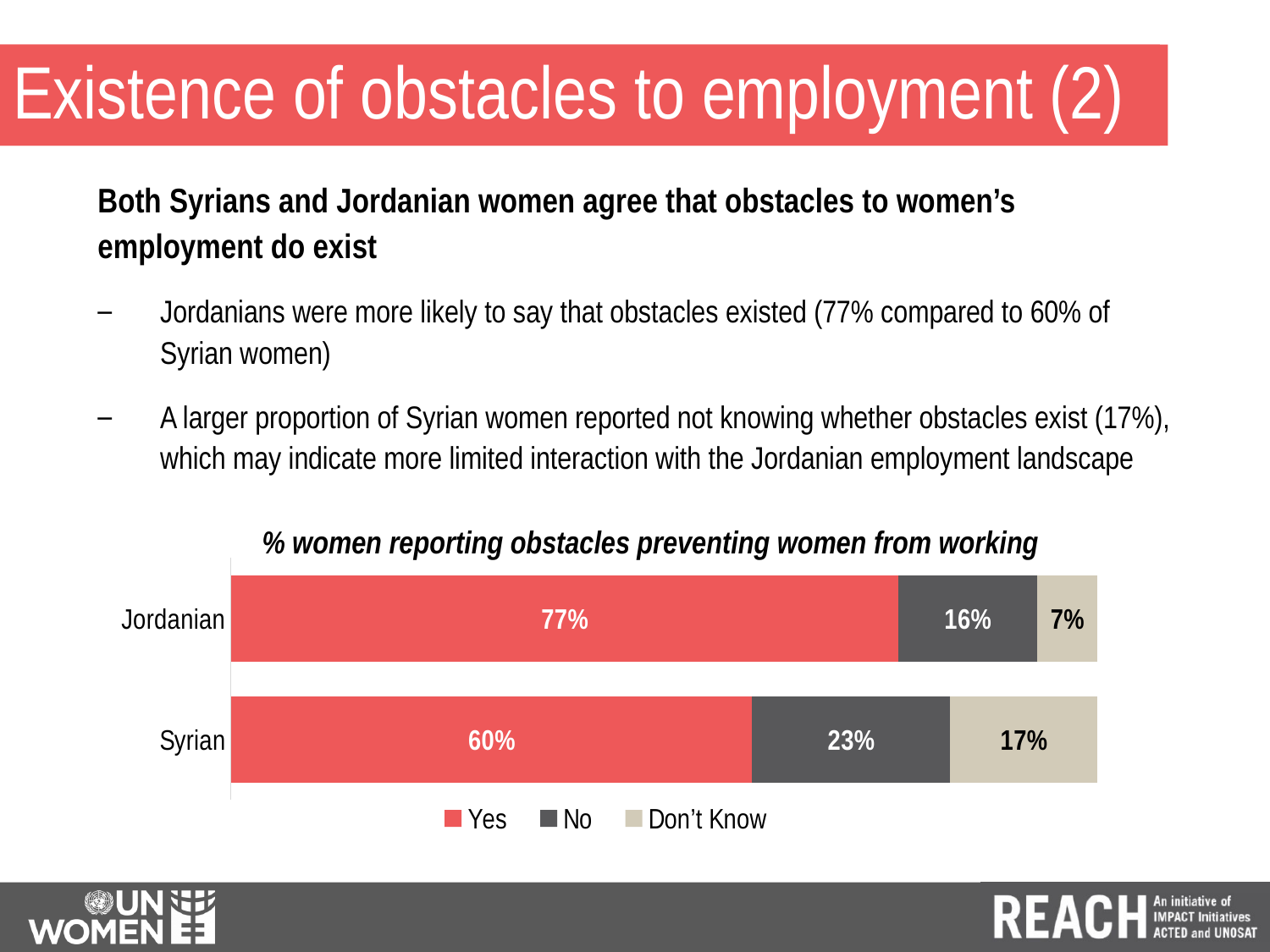
What is the difference between the "Don't Know" shares for Syrian and Jordanian women? 10% What type of chart is shown on the slide? Stacked bar chart How many categories (groups) are shown on the chart? 2 What percentage of Jordanian women answered "Yes" to obstacles preventing women from working? 77% What percentage of Syrian women answered "No"? 23% What percentage of Syrian women answered "Don't Know"? 17% What percentage of Jordanian women answered "Don't Know"? 7% Which group has the lower "No" share? Jordanian What is the total of the three segments in the Syrian bar? 100% What is the difference between the "Yes" shares for Jordanian and Syrian women? 17% How many series does the legend list? 3 Which group has the higher "Yes" share, Jordanian or Syrian? Jordanian